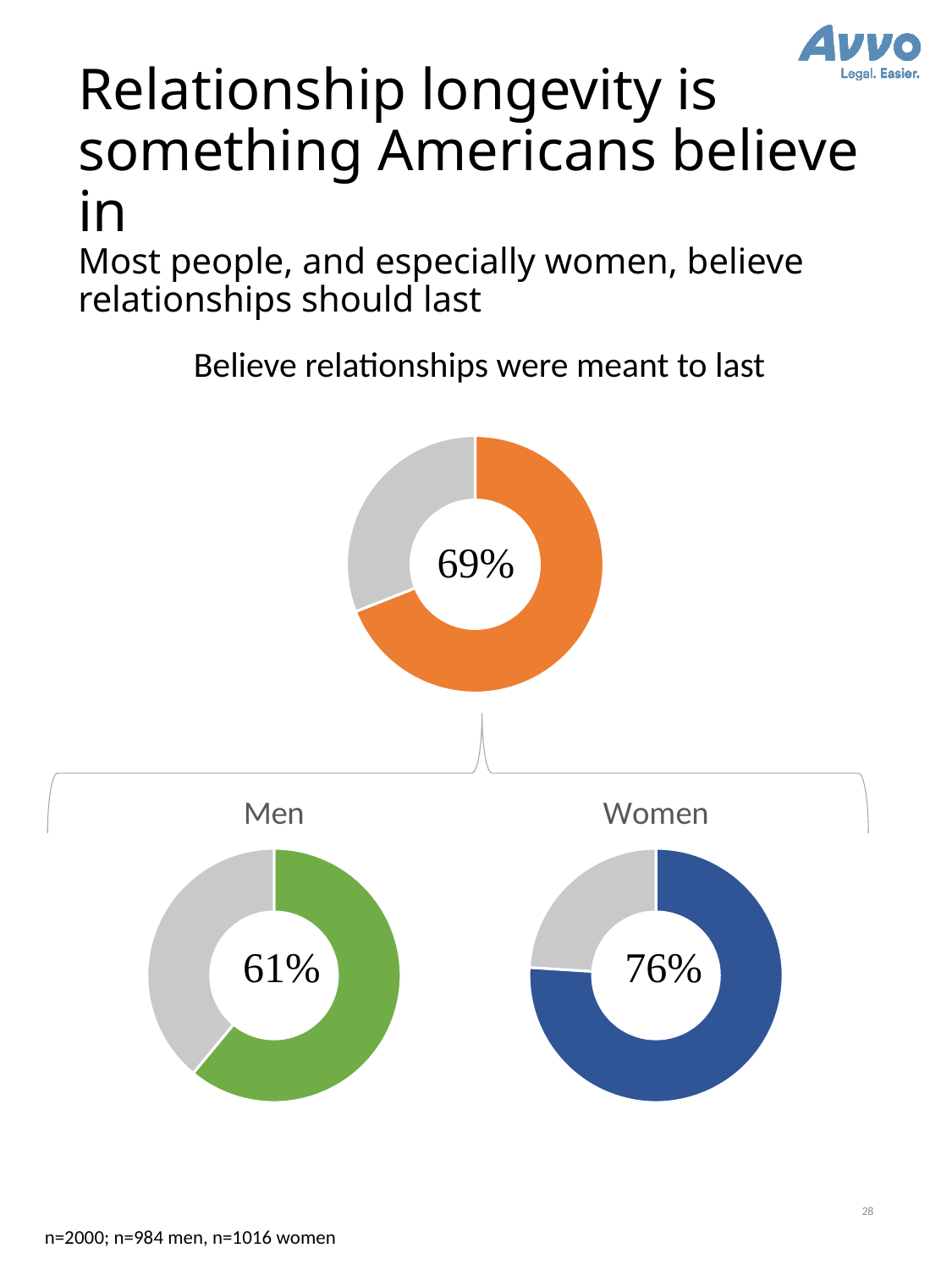
In the 'Women' donut chart, what percentage of women believe relationships were meant to last? 76% What percentage is shown in the top donut chart titled 'Believe relationships were meant to last'? 69% What colour is the highlighted segment in the 'Women' donut chart? Blue Is the value in the 'Men' donut chart greater or less than 50%? greater What is the title above the top donut chart? Believe relationships were meant to last In the 'Men' donut chart, what percentage of men believe relationships were meant to last? 61% What is the difference between the 'Women' chart percentage and the overall percentage in the top chart? 7% How many donut charts are shown on the slide? 3 What is the difference between the percentage in the 'Women' chart and the percentage in the 'Men' chart? 15% Comparing the 'Men' and 'Women' donut charts, which group has the higher share believing relationships were meant to last? Women What type of chart is used to show the 'Men' value? Donut (pie) chart What is the difference between the overall percentage (top chart) and the 'Men' chart percentage? 8%